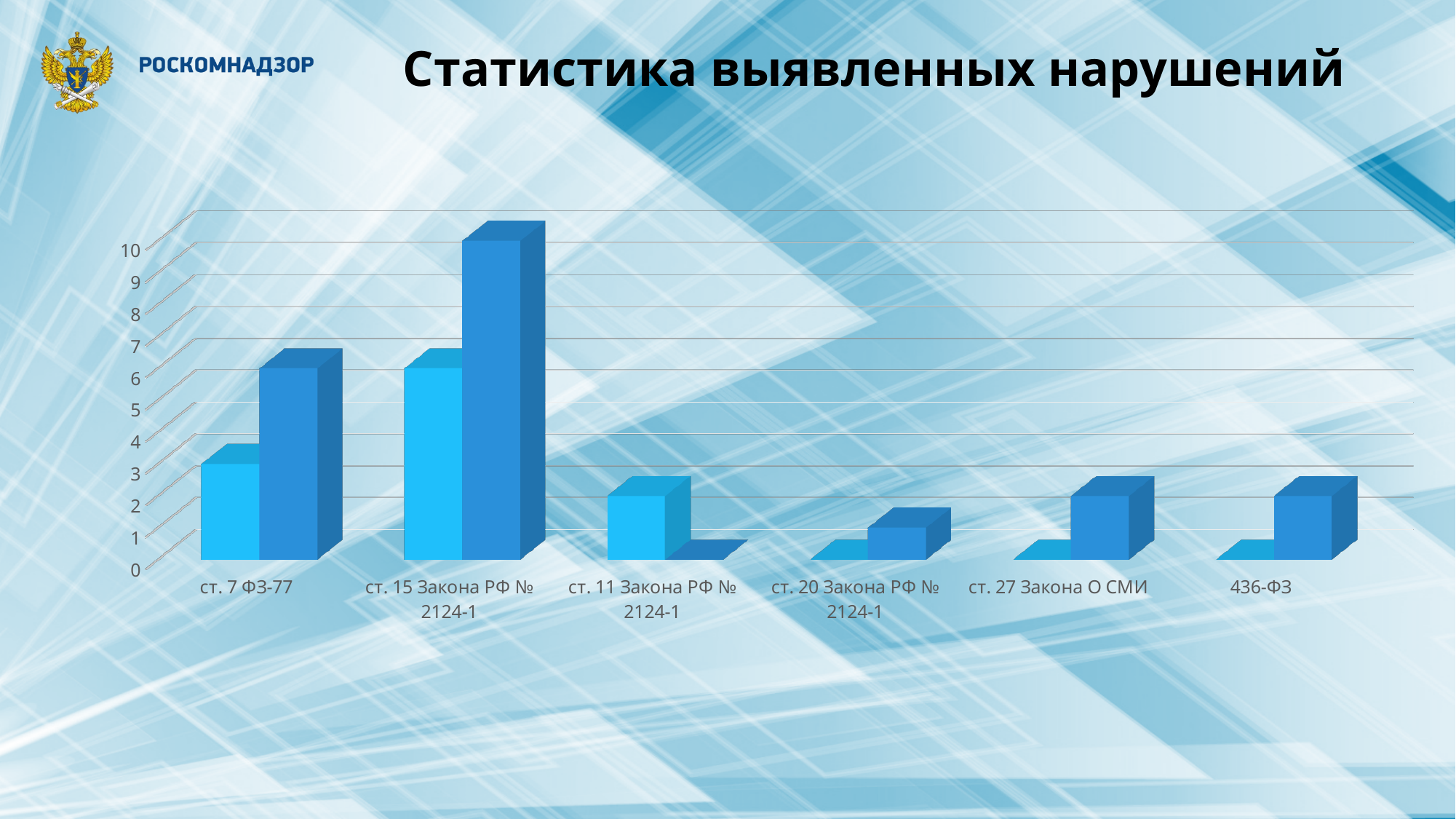
Is the light blue bar for ст. 15 Закона РФ № 2124-1 greater or less than 4? greater What is the title of the chart? Статистика выявленных нарушений What is the highest value labelled on the vertical axis of the chart? 10 Is the light blue bar for ст. 11 Закона РФ № 2124-1 greater or less than 4? less Is the dark blue bar for ст. 15 Закона РФ № 2124-1 greater or less than 8? greater How many categories are shown on the x axis of the chart? 6 Which has the larger light blue bar: ст. 7 ФЗ-77 or ст. 11 Закона РФ № 2124-1? ст. 7 ФЗ-77 Which has the larger dark blue bar: ст. 7 ФЗ-77 or ст. 15 Закона РФ № 2124-1? ст. 15 Закона РФ № 2124-1 What kind of chart is shown on the slide? bar chart Which category has the tallest bar in the chart? ст. 15 Закона РФ № 2124-1